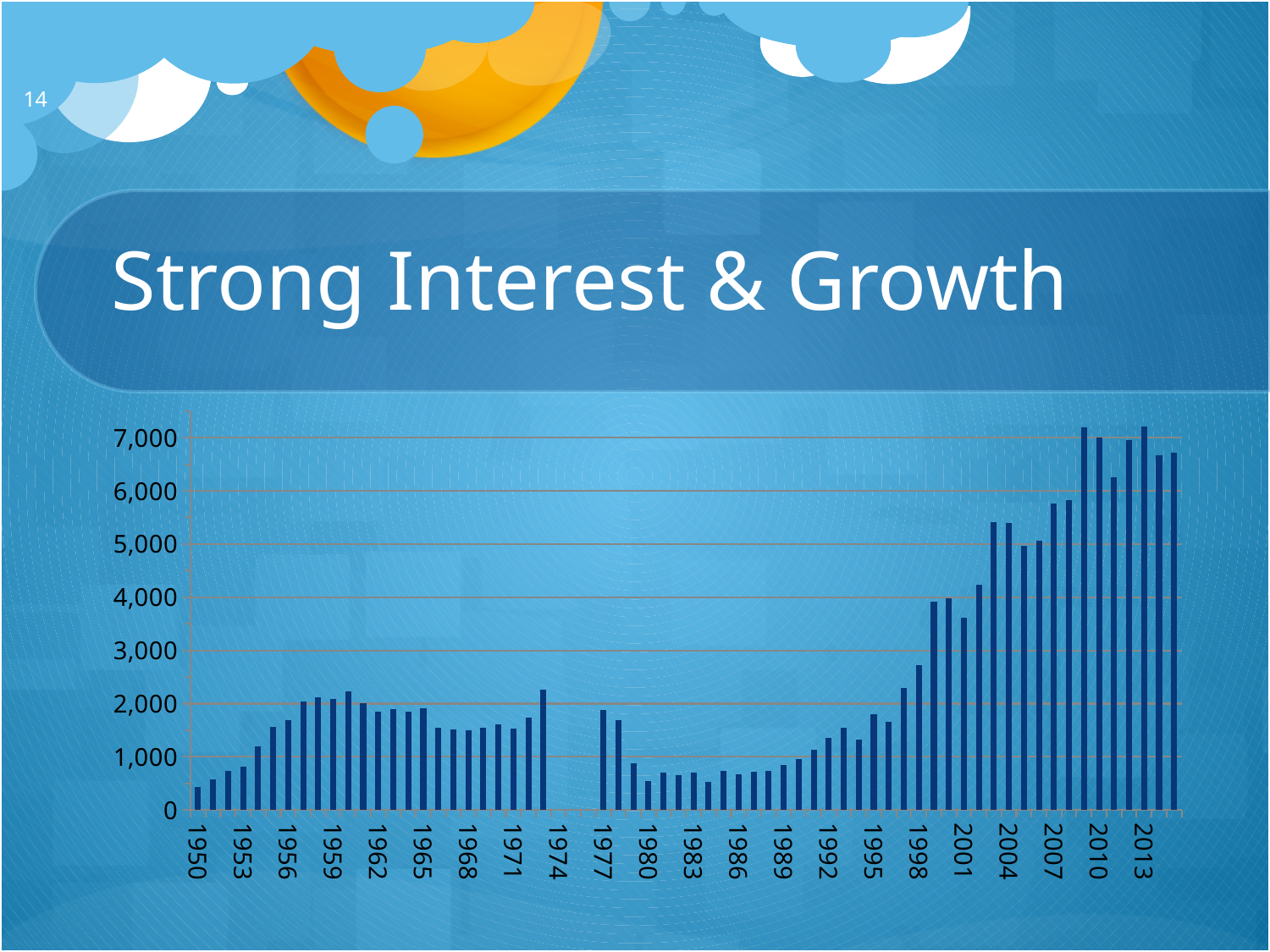
What kind of chart is shown on the slide? bar chart Is the value for 1998 greater or less than 2,000? greater Is the value for 2001 greater or less than 3,000? greater Is the value for 2004 greater or less than 5,000? greater What is the title of the slide containing the chart? Strong Interest & Growth Which is larger, the value for 1980 or the value for 1998? 1998 Do the values generally rise or fall from 1986 to 2004? rise Which is larger, the value for 1950 or the value for 2007? 2007 What is the highest value labelled on the vertical axis of the chart? 7,000